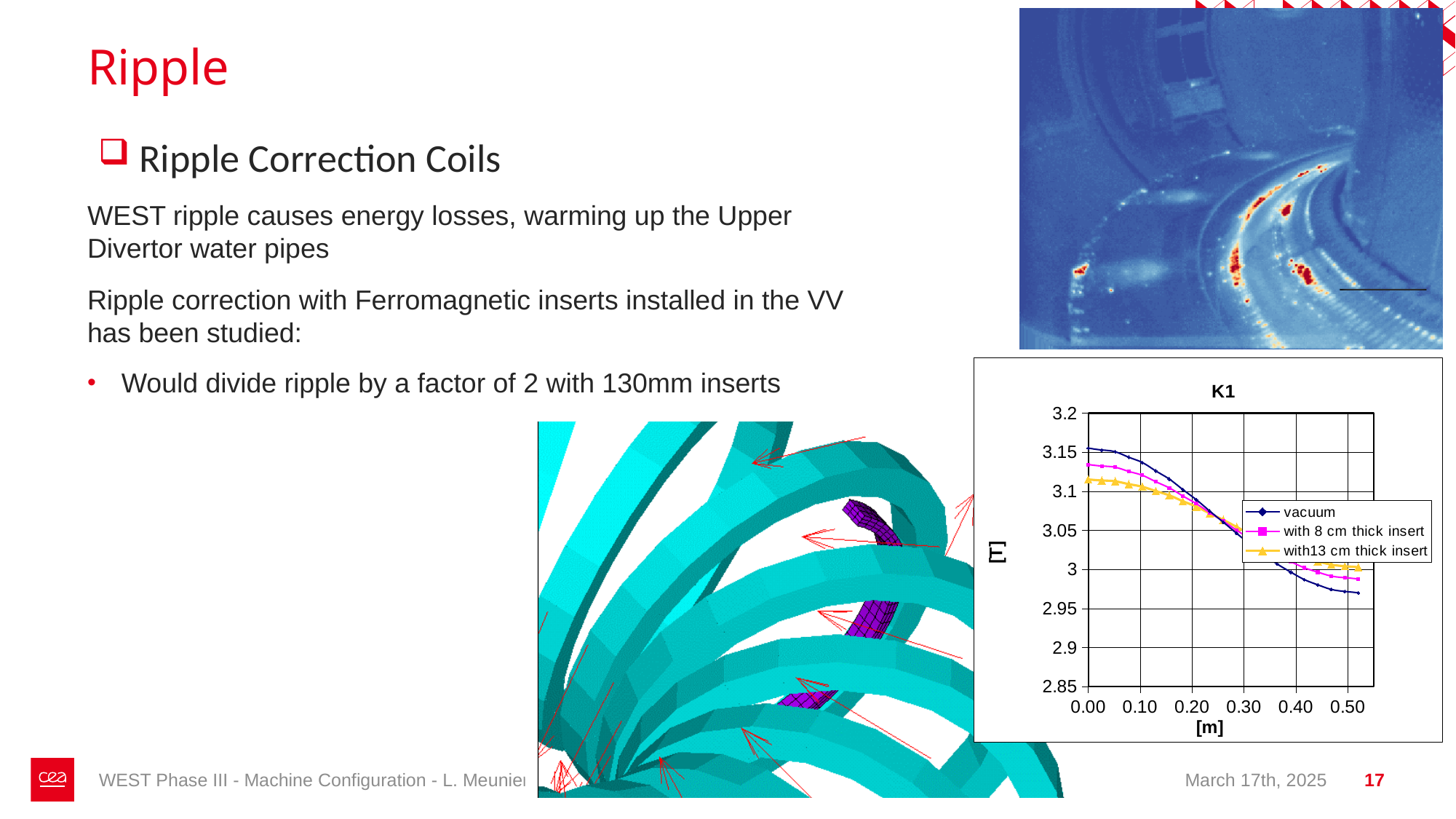
What kind of chart is the K1 chart? line chart What is the title of the chart on the slide? K1 In the K1 chart, is the value of the vacuum series at 0.00 m greater or less than 3.1? greater In the K1 chart, at 0.50 m, which is higher: the vacuum series or the 'with13 cm thick insert' series? with13 cm thick insert In the K1 chart, at 0.00 m, which is higher: the vacuum series or the 'with13 cm thick insert' series? vacuum In the K1 chart, which series has the lowest value at 0.50 m? vacuum In the K1 chart, do the values of the vacuum series rise or fall as the x axis increases? fall What is the x-axis label of the K1 chart? [m] In the K1 chart, is the value of the 'with 8 cm thick insert' series at 0.00 m greater or less than 3.1? greater In the K1 chart, which series has the highest value at 0.00 m? vacuum How many series does the legend of the K1 chart list? 3 In the K1 chart, is the value of the vacuum series at 0.50 m greater or less than 3? less